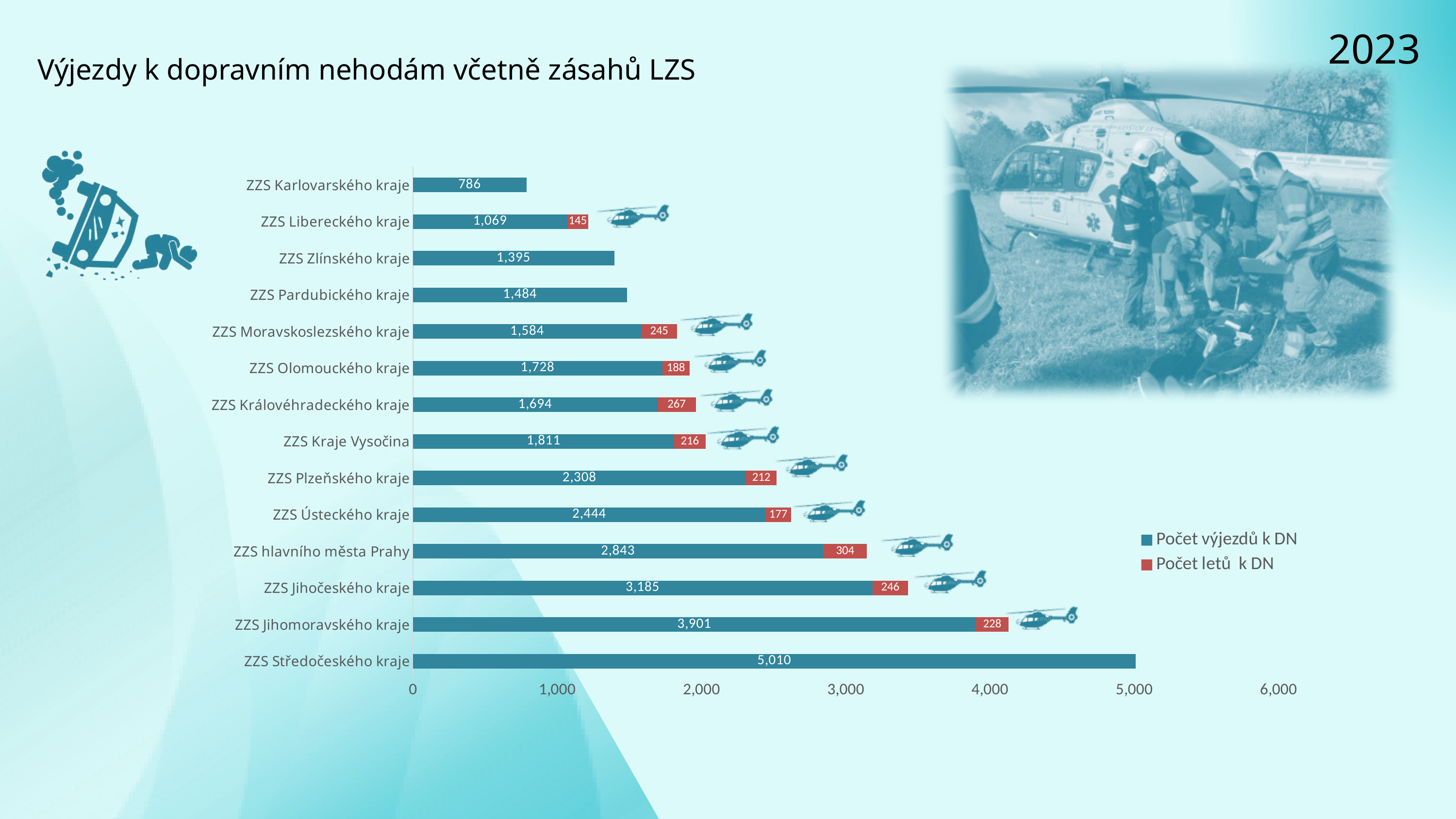
What is the difference in Počet výjezdů k DN between ZZS Středočeského kraje and ZZS Jihomoravského kraje? 1,109 What kind of chart is shown on the slide? Stacked bar chart What is the title of the chart? Výjezdy k dopravním nehodám včetně zásahů LZS What is the value of Počet výjezdů k DN for ZZS Středočeského kraje? 5,010 What is the total of the stacked bar for ZZS hlavního města Prahy? 3,147 What is the value of Počet letů k DN for ZZS hlavního města Prahy? 304 What is the value of Počet výjezdů k DN for ZZS Karlovarského kraje? 786 Which has a larger Počet letů k DN: ZZS Královéhradeckého kraje or ZZS Olomouckého kraje? ZZS Královéhradeckého kraje How many series does the legend list? 2 How many regions are shown on the chart? 14 Which region has the highest Počet výjezdů k DN? ZZS Středočeského kraje Which region has the lowest Počet letů k DN among those with a red segment? ZZS Libereckého kraje